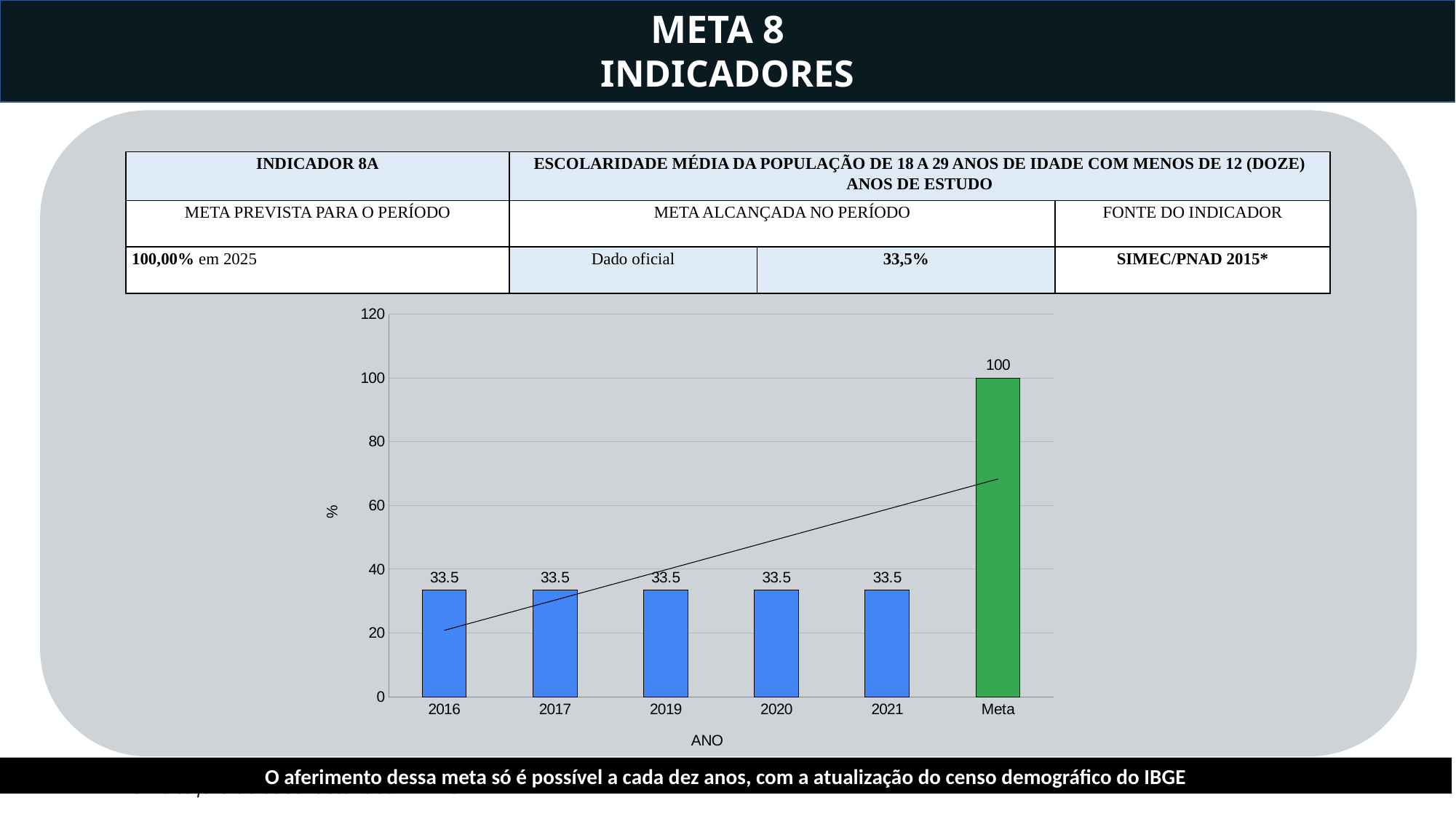
Do the values for the years 2016 through 2021 rise, fall, or stay the same? stay the same Is the value for 2020 greater or less than 40? less Which is larger, the value for 2019 or the value for Meta? Meta How many bars are plotted in the chart? 6 What kind of chart is shown on the slide? bar chart Which category has the highest value in the chart? Meta What colour is the Meta bar in the chart? green What is the label of the x axis of the chart? ANO What is the value for the Meta bar in the chart? 100 What is the value for 2016 in the bar chart? 33.5 What is the value for 2021 in the bar chart? 33.5 What is the difference between the Meta bar and the 2021 bar? 66.5